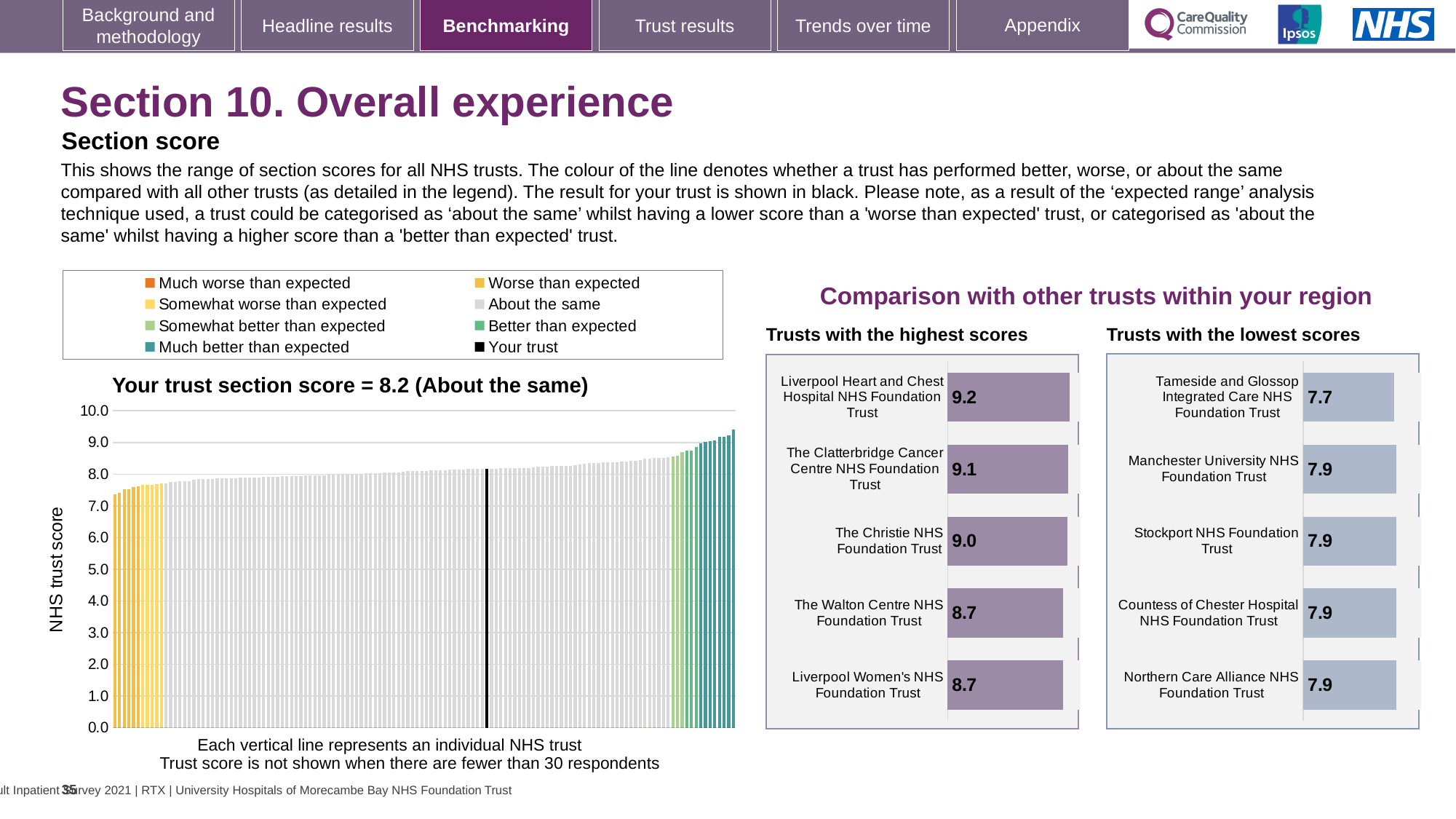
In the 'Trusts with the highest scores' chart, what is the difference between the scores of Liverpool Heart and Chest Hospital NHS Foundation Trust and The Walton Centre NHS Foundation Trust? 0.5 In the 'Your trust section score' chart, what is the label on the vertical axis? NHS trust score How many trusts are listed in the 'Trusts with the lowest scores' chart? 5 In the 'Trusts with the lowest scores' chart, which trust has the lowest score? Tameside and Glossop Integrated Care NHS Foundation Trust In the 'Your trust section score' chart, what is the section score for your trust? 8.2 In the 'Trusts with the highest scores' chart, which trust has the highest score? Liverpool Heart and Chest Hospital NHS Foundation Trust In the 'Trusts with the lowest scores' chart, what is the score for Stockport NHS Foundation Trust? 7.9 In the 'Trusts with the highest scores' chart, what is the score for The Christie NHS Foundation Trust? 9.0 In the 'Trusts with the highest scores' chart, which has a higher score: The Clatterbridge Cancer Centre NHS Foundation Trust or Liverpool Women's NHS Foundation Trust? The Clatterbridge Cancer Centre NHS Foundation Trust In the 'Trusts with the lowest scores' chart, what is the score for Tameside and Glossop Integrated Care NHS Foundation Trust? 7.7 In the 'Trusts with the highest scores' chart, what is the score for Liverpool Heart and Chest Hospital NHS Foundation Trust? 9.2 What type of chart is the 'Trusts with the highest scores' chart? Bar chart